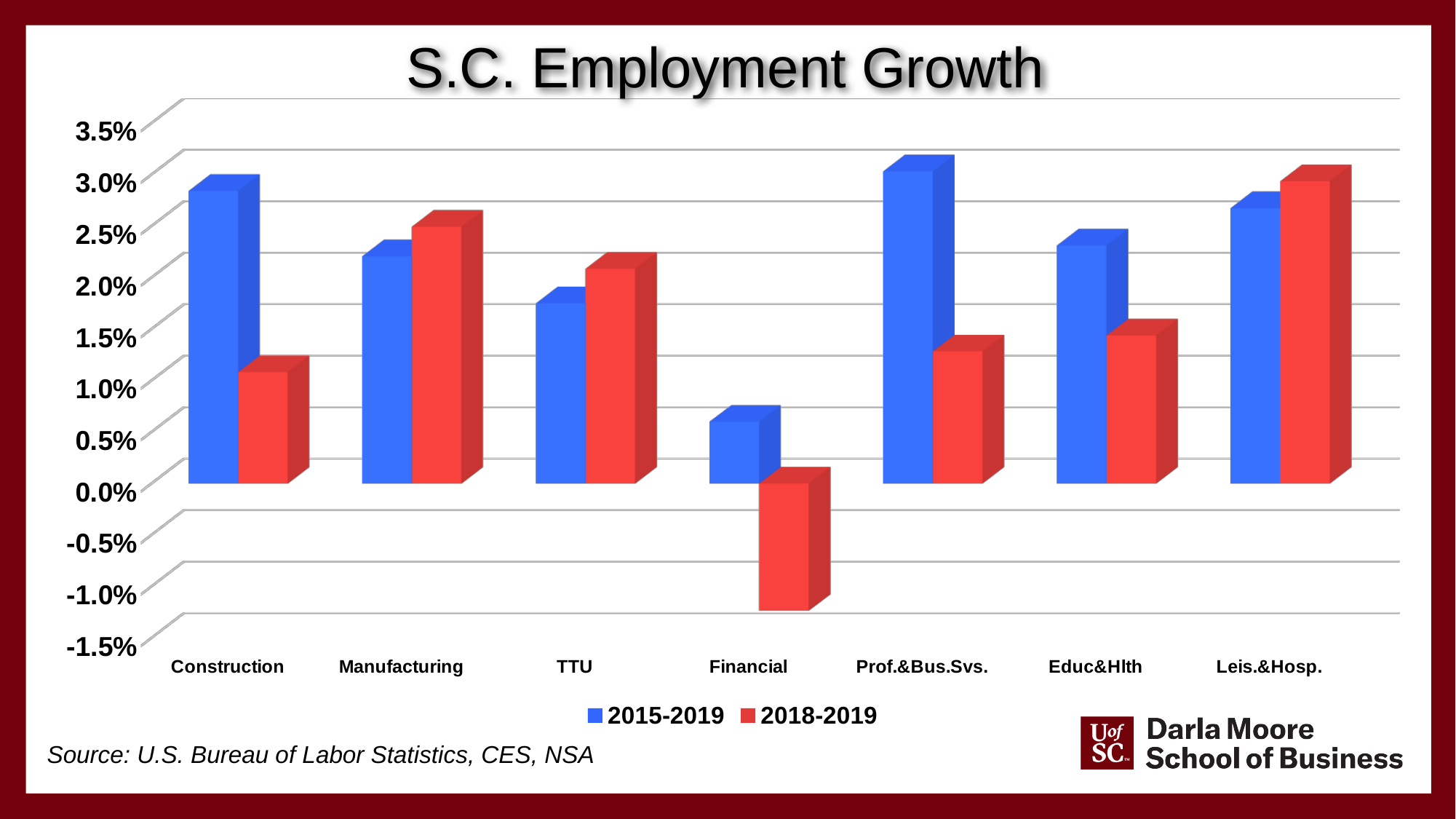
For Manufacturing, which series is larger, 2015-2019 or 2018-2019? 2018-2019 How many industry categories are shown on the x axis? 7 Is the 2018-2019 value for Financial greater or less than 0.0%? less What kind of chart is shown on the slide? bar chart Which category has the highest 2018-2019 employment growth? Leis.&Hosp. For Construction, which series is larger, 2015-2019 or 2018-2019? 2015-2019 How many series does the legend list? 2 Which category has the highest 2015-2019 employment growth? Prof.&Bus.Svs. Which category has the lowest 2018-2019 employment growth? Financial Is the 2015-2019 value for Construction greater or less than 2.5%? greater Which category has the lowest 2015-2019 employment growth? Financial What is the title of the chart? S.C. Employment Growth